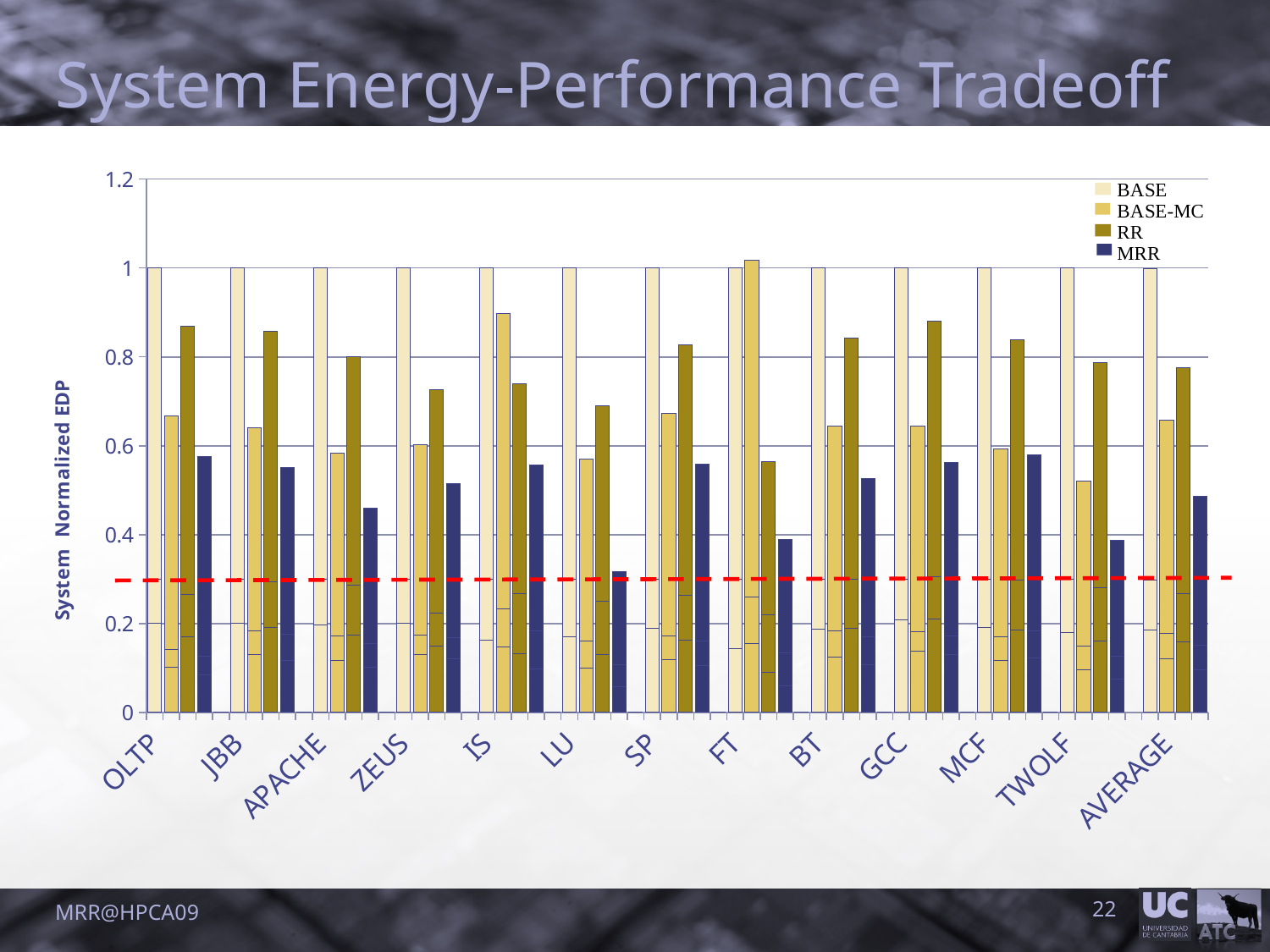
Is the BASE-MC value for IS greater or less than 0.8? greater What is the title of the slide containing the chart? System Energy-Performance Tradeoff Is the MRR value for LU greater or less than 0.4? less For GCC, which is larger, the RR value or the MRR value? RR What is the System Normalized EDP value of the BASE series for OLTP? 1 Which category has the highest BASE-MC value? FT Is the RR value for OLTP greater or less than 0.8? greater Which category has the lowest MRR value? LU How many categories are shown along the x axis? 13 What kind of chart is shown on the slide? bar chart How many series does the legend list? 4